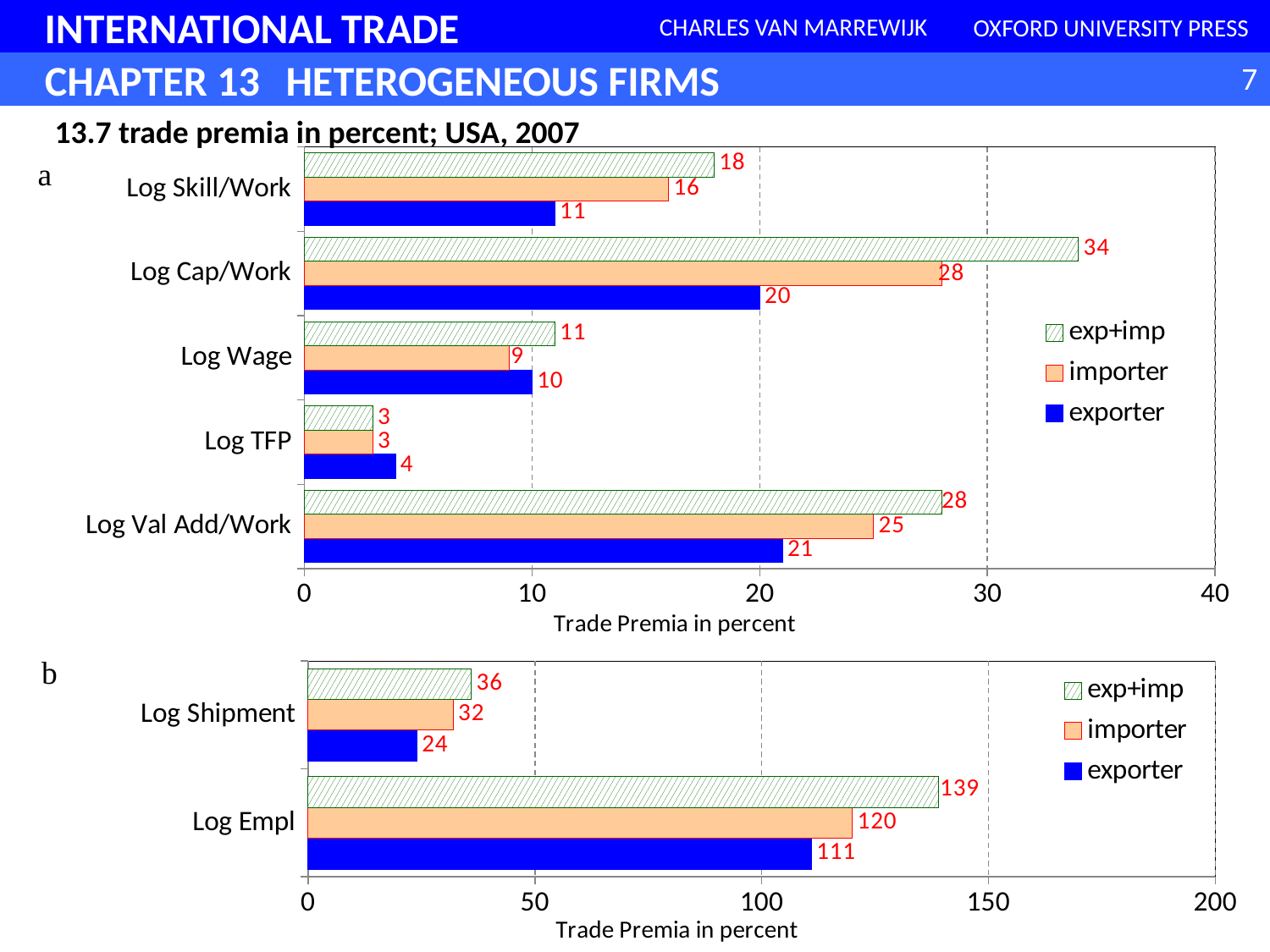
In chart a (top chart), what is the exporter value for Log Val Add/Work? 21 In chart b (bottom chart), what is the importer value for Log Empl? 120 How many series does the legend of chart b (bottom chart) list? 3 In chart a (top chart), what is the exp+imp value for Log Cap/Work? 34 What type of chart is chart b (bottom chart)? bar chart What is the x-axis label of chart a (top chart)? Trade Premia in percent In chart b (bottom chart), what is the difference between the exp+imp and exporter values for Log Empl? 28 In chart a (top chart), which is larger for Log Wage: the exporter value or the importer value? exporter In chart a (top chart), which category has the lowest exporter value? Log TFP In chart a (top chart), which category has the highest exp+imp value? Log Cap/Work In chart a (top chart), what is the difference between the importer and exporter values for Log Skill/Work? 5 How many categories are shown in chart a (top chart)? 5